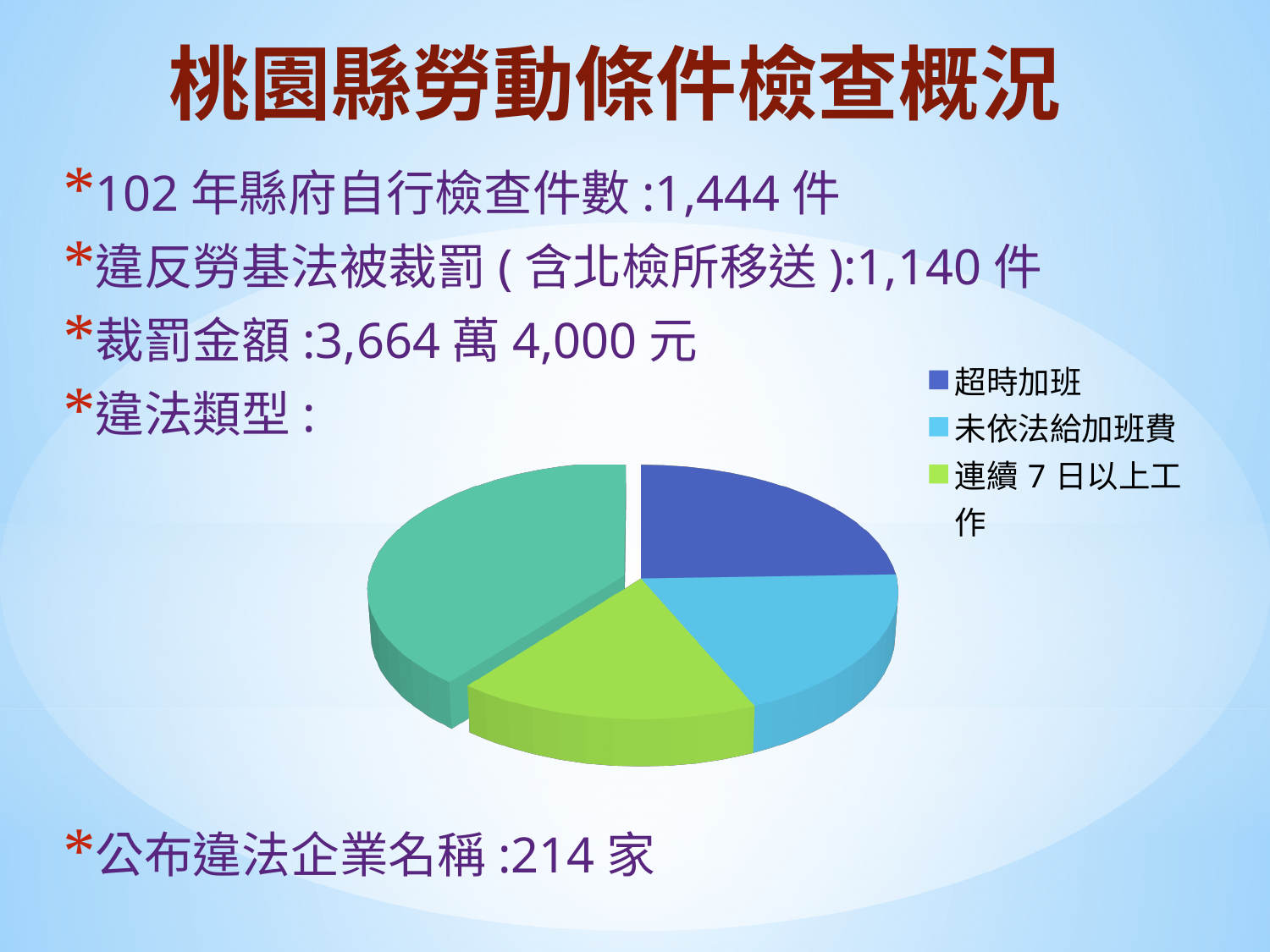
Which slice is larger in the pie chart, 連續 7 日以上工作 or 超時加班? 超時加班 Which category is listed first in the pie chart's legend? 超時加班 What kind of chart is shown on the slide? pie chart How many entries does the legend of the pie chart list? 3 What colour is the 超時加班 slice in the pie chart? dark blue Does the 超時加班 slice take up more or less than half of the pie chart? less Among the categories listed in the legend, which one has the largest slice in the pie chart? 超時加班 How many slices does the pie chart have? 4